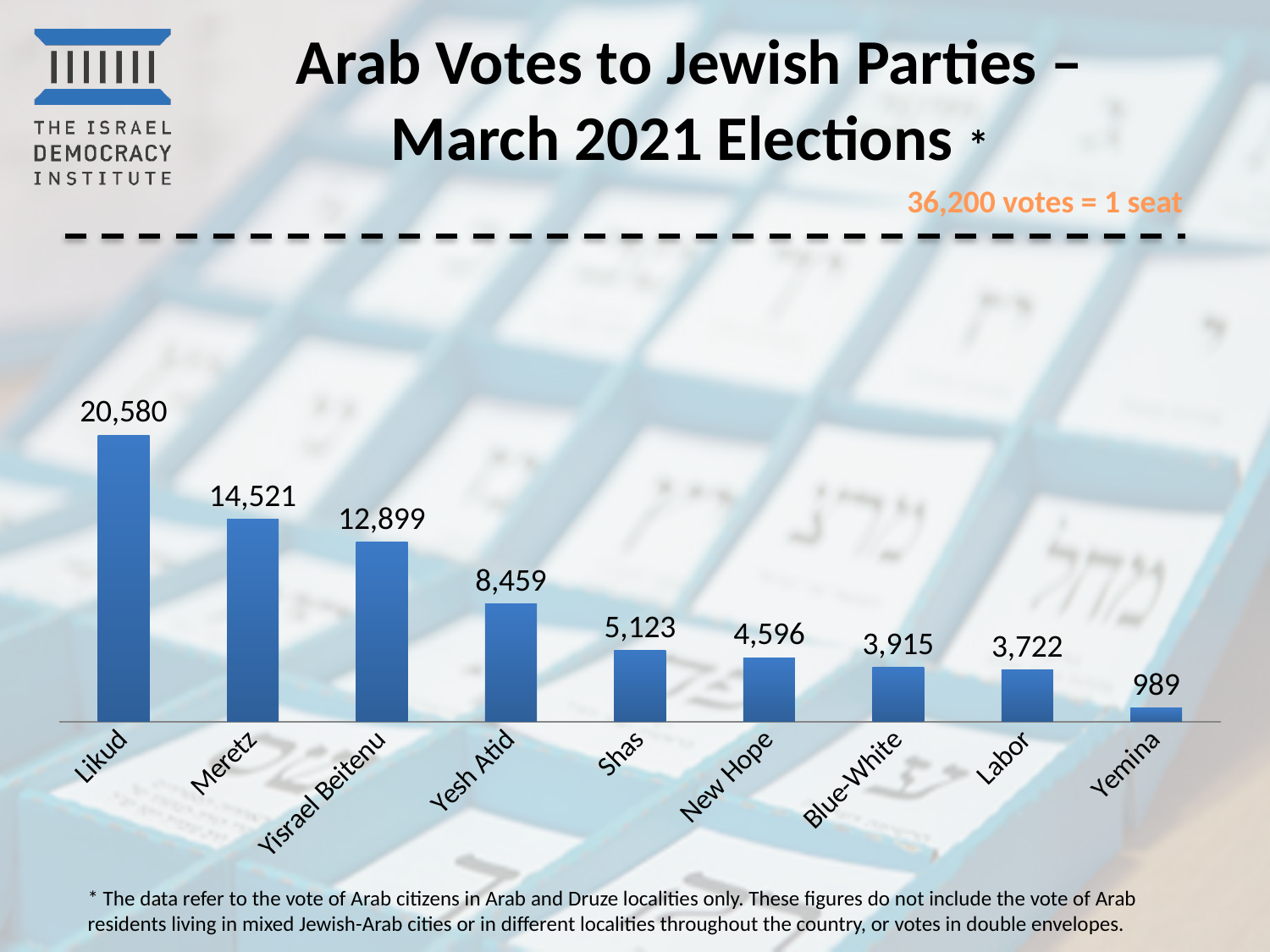
What is the difference between the votes for Likud and Meretz? 6,059 Which received more votes, Yisrael Beitenu or Yesh Atid? Yisrael Beitenu What is the difference between the votes for Shas and New Hope? 527 Which party has the lowest number of votes in the chart? Yemina Do the values rise or fall moving from left to right along the x axis? Fall What is the value shown for Yesh Atid? 8,459 Which received more votes, Labor or Blue-White? Blue-White What is the value shown for Blue-White? 3,915 How many votes did Likud receive according to the chart? 20,580 Which party has the highest number of votes in the chart? Likud What type of chart is shown on the slide? Bar chart How many parties are shown in the chart? 9